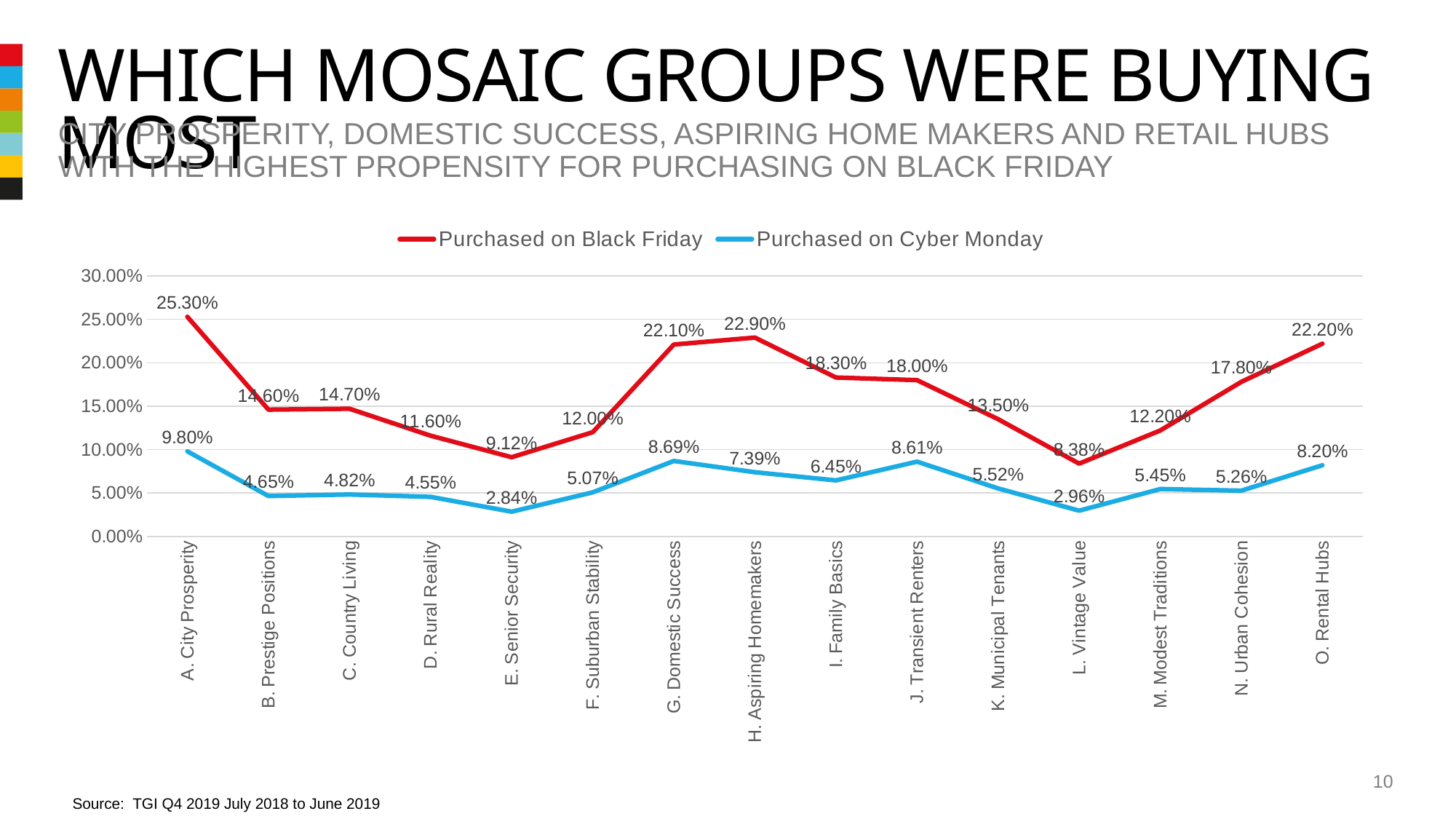
Which Mosaic group has the highest Purchased on Black Friday value? A. City Prosperity Which Mosaic group has the lowest Purchased on Cyber Monday value? E. Senior Security How many series does the legend list? 2 What is the Purchased on Black Friday value for A. City Prosperity? 25.30% What is the difference between the Purchased on Black Friday and Purchased on Cyber Monday values for A. City Prosperity? 15.50% What type of chart is shown on the slide? Line chart What is the Purchased on Cyber Monday value for G. Domestic Success? 8.69% What is the Purchased on Black Friday value for O. Rental Hubs? 22.20% Which is larger for H. Aspiring Homemakers: the Purchased on Black Friday value or the Purchased on Cyber Monday value? Purchased on Black Friday How many Mosaic groups are plotted along the x axis? 15 What colour is the Purchased on Cyber Monday line? Blue Which Mosaic group has the lowest Purchased on Black Friday value? L. Vintage Value